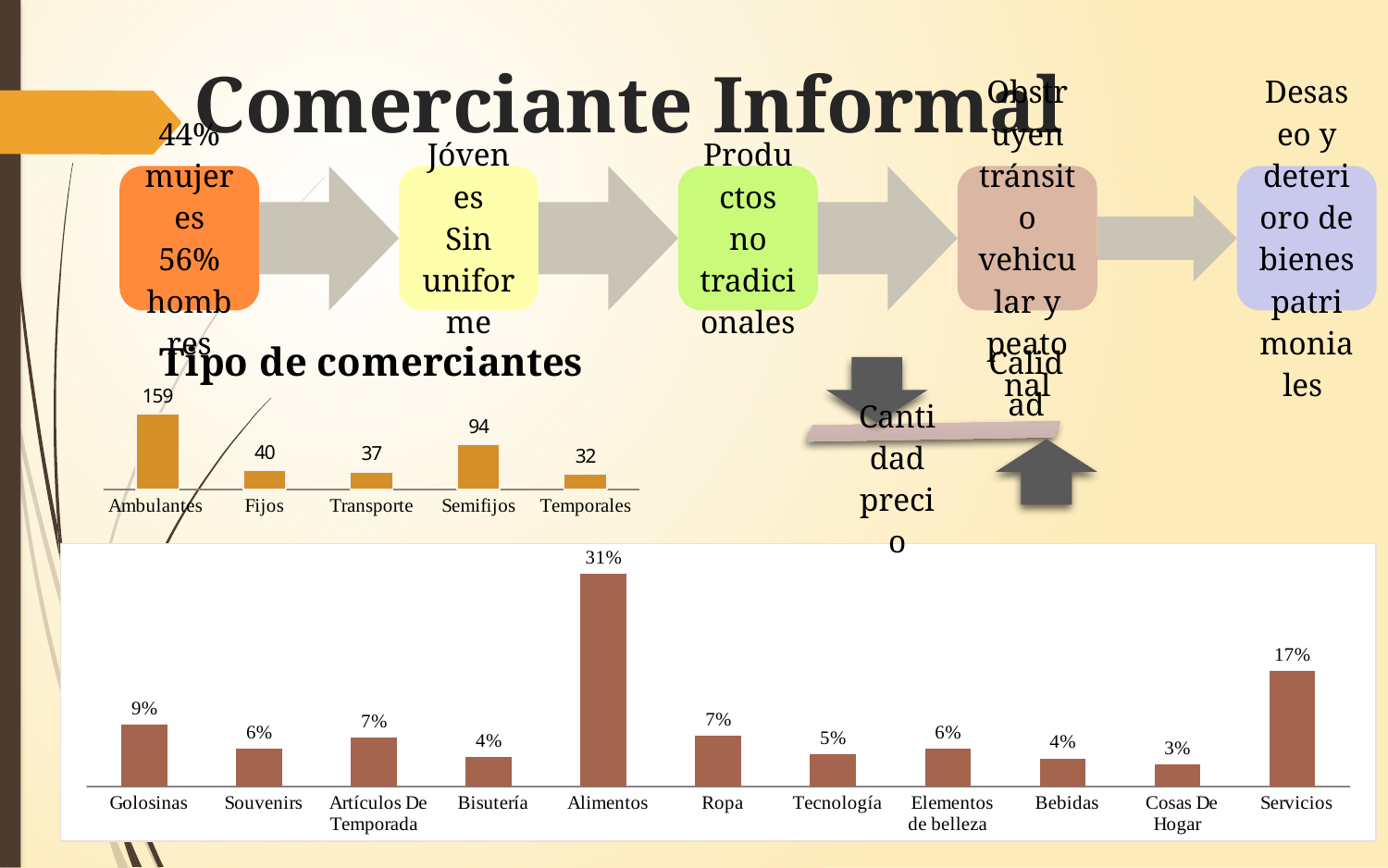
In the 'Tipo de comerciantes' chart, what is the difference between Ambulantes and Semifijos? 65 What type of chart is the 'Tipo de comerciantes' chart? Bar chart In the bar chart at the bottom of the slide, what is the difference between Alimentos and Servicios? 14% In the bar chart at the bottom of the slide, which category has the lowest value? Cosas De Hogar In the bar chart at the bottom of the slide, how many categories are shown? 11 In the 'Tipo de comerciantes' chart, what is the value for Semifijos? 94 In the bar chart at the bottom of the slide, what is the value for Servicios? 17% In the bar chart at the bottom of the slide, what is the value for Alimentos? 31% In the 'Tipo de comerciantes' chart, what is the value for Ambulantes? 159 In the 'Tipo de comerciantes' chart, how many categories are shown? 5 In the 'Tipo de comerciantes' chart, which category has the lowest value? Temporales In the 'Tipo de comerciantes' chart, which is larger, Fijos or Transporte? Fijos